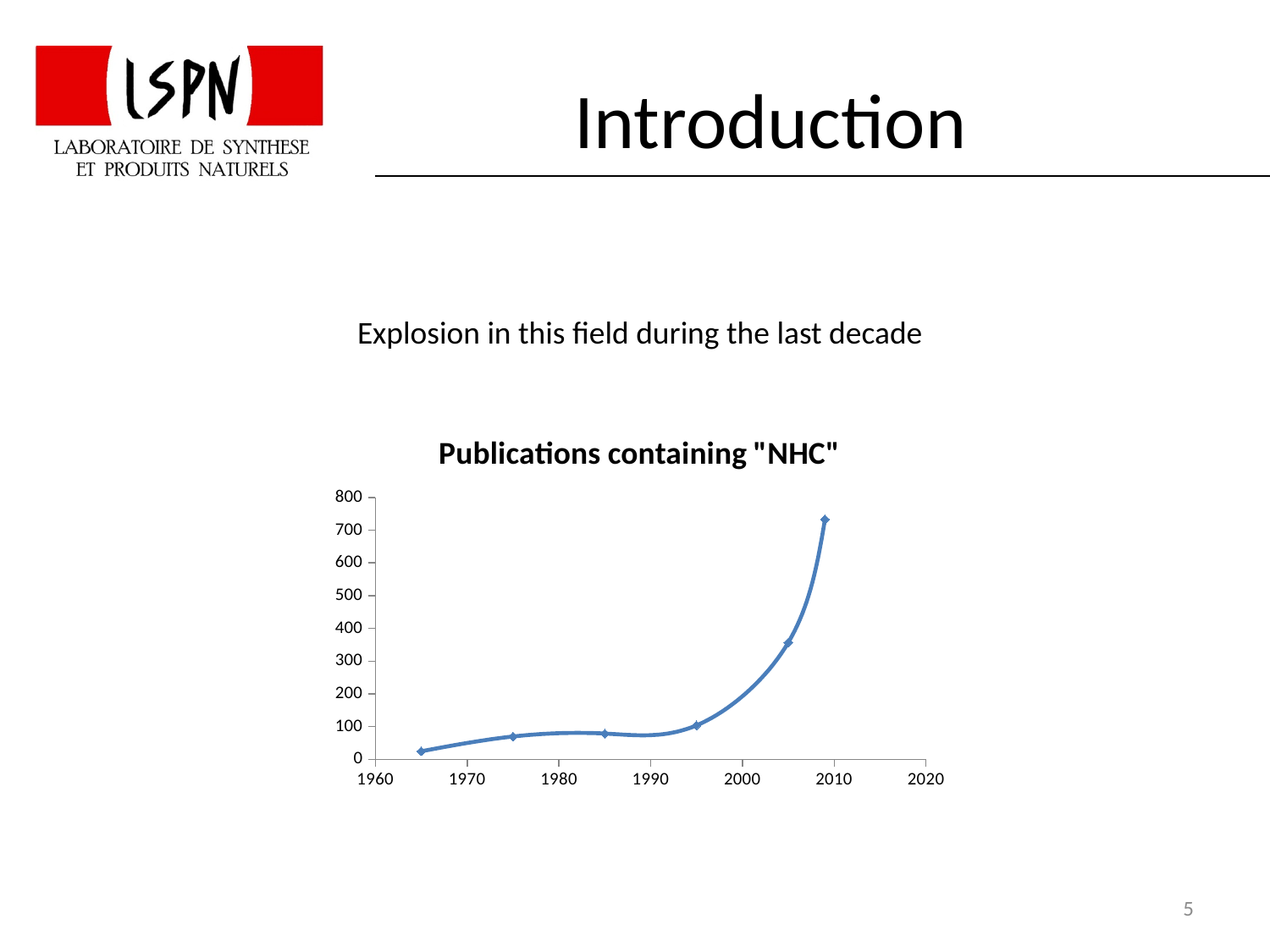
What kind of chart is shown on the slide? line chart How many data points are plotted on the chart? 6 Is the value of the leftmost data point (near 1965) greater or less than 100? less What is the highest value shown on the y axis? 800 Is the value of the rightmost data point (just before 2010) greater or less than 600? greater Is the value of the data point plotted near 1975 greater or less than 200? less Which data point has the highest value, the leftmost one or the rightmost one? the rightmost one What is the title of the chart? Publications containing "NHC" Do the values generally rise or fall as the year increases along the x axis? rise Is the value of the data point near 2005 larger or smaller than the value of the data point near 1995? larger